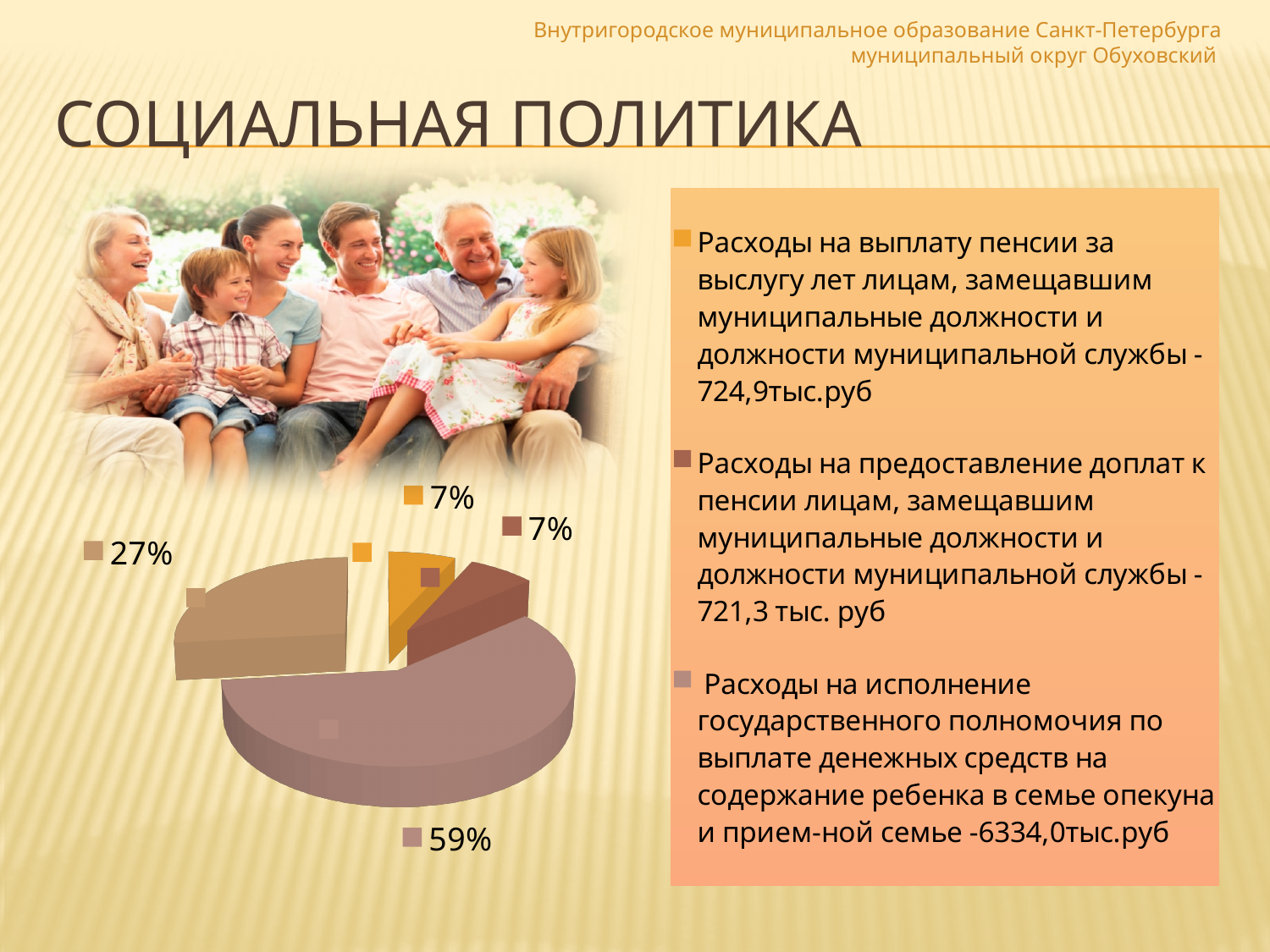
Which is larger: the 27% slice or the 59% slice? the 59% slice What share of the pie does the orange slice represent? 7% What share of the pie does the large pinkish-brown slice represent? 59% How many slices does the pie chart have? 4 How many slices of the pie chart are labelled 7%? 2 What is the title of the slide containing the pie chart? Социальная политика What is the difference in percentage points between the largest slice (59%) and the 27% slice? 32 Is the largest slice of the pie chart greater or less than 50%? greater What do the four percentage labels on the pie chart add up to? 100% What is the largest share shown in the pie chart? 59% What is the smallest share shown in the pie chart? 7% What kind of chart is shown on the slide? pie chart